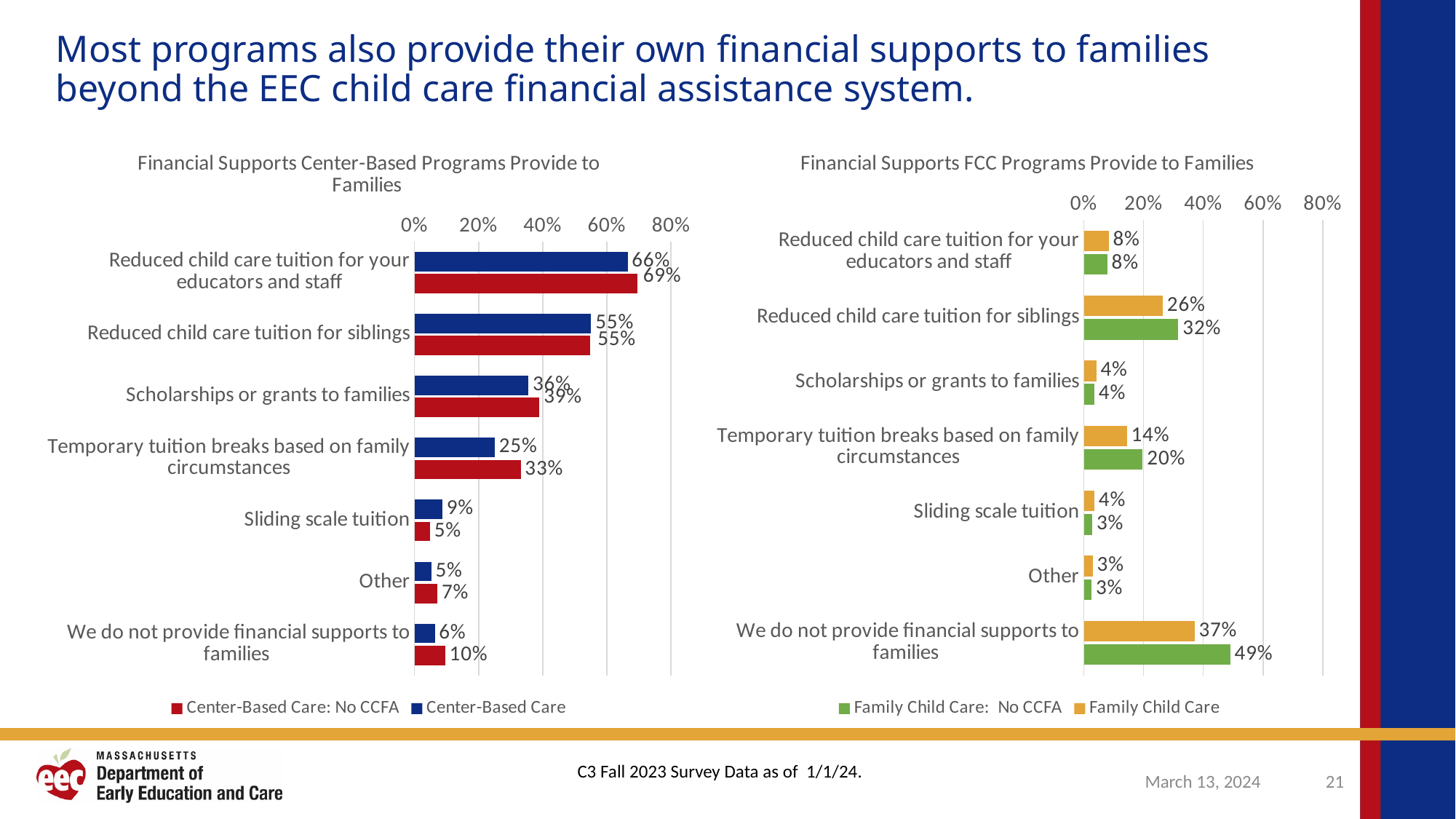
How many categories are shown in the 'Financial Supports FCC Programs Provide to Families' chart? 7 In the 'Financial Supports FCC Programs Provide to Families' chart, what is the difference between the Family Child Care: No CCFA and Family Child Care values for 'We do not provide financial supports to families'? 12% In the 'Financial Supports Center-Based Programs Provide to Families' chart, which category has the highest Center-Based Care: No CCFA value? Reduced child care tuition for your educators and staff How many series does the legend of the 'Financial Supports Center-Based Programs Provide to Families' chart list? 2 In the 'Financial Supports Center-Based Programs Provide to Families' chart, what is the Center-Based Care: No CCFA value for 'Temporary tuition breaks based on family circumstances'? 33% What type of chart is the 'Financial Supports FCC Programs Provide to Families' chart? Bar chart In the 'Financial Supports FCC Programs Provide to Families' chart, which category has the highest Family Child Care value? We do not provide financial supports to families In the 'Financial Supports Center-Based Programs Provide to Families' chart, which is larger for 'Sliding scale tuition': Center-Based Care or Center-Based Care: No CCFA? Center-Based Care In the 'Financial Supports FCC Programs Provide to Families' chart, what is the Family Child Care: No CCFA value for 'We do not provide financial supports to families'? 49% In the 'Financial Supports FCC Programs Provide to Families' chart, what is the Family Child Care value for 'Reduced child care tuition for siblings'? 26% In the 'Financial Supports Center-Based Programs Provide to Families' chart, what is the Center-Based Care value for 'Reduced child care tuition for your educators and staff'? 66% In the 'Financial Supports Center-Based Programs Provide to Families' chart, what is the difference between the Center-Based Care: No CCFA and Center-Based Care values for 'Temporary tuition breaks based on family circumstances'? 8%